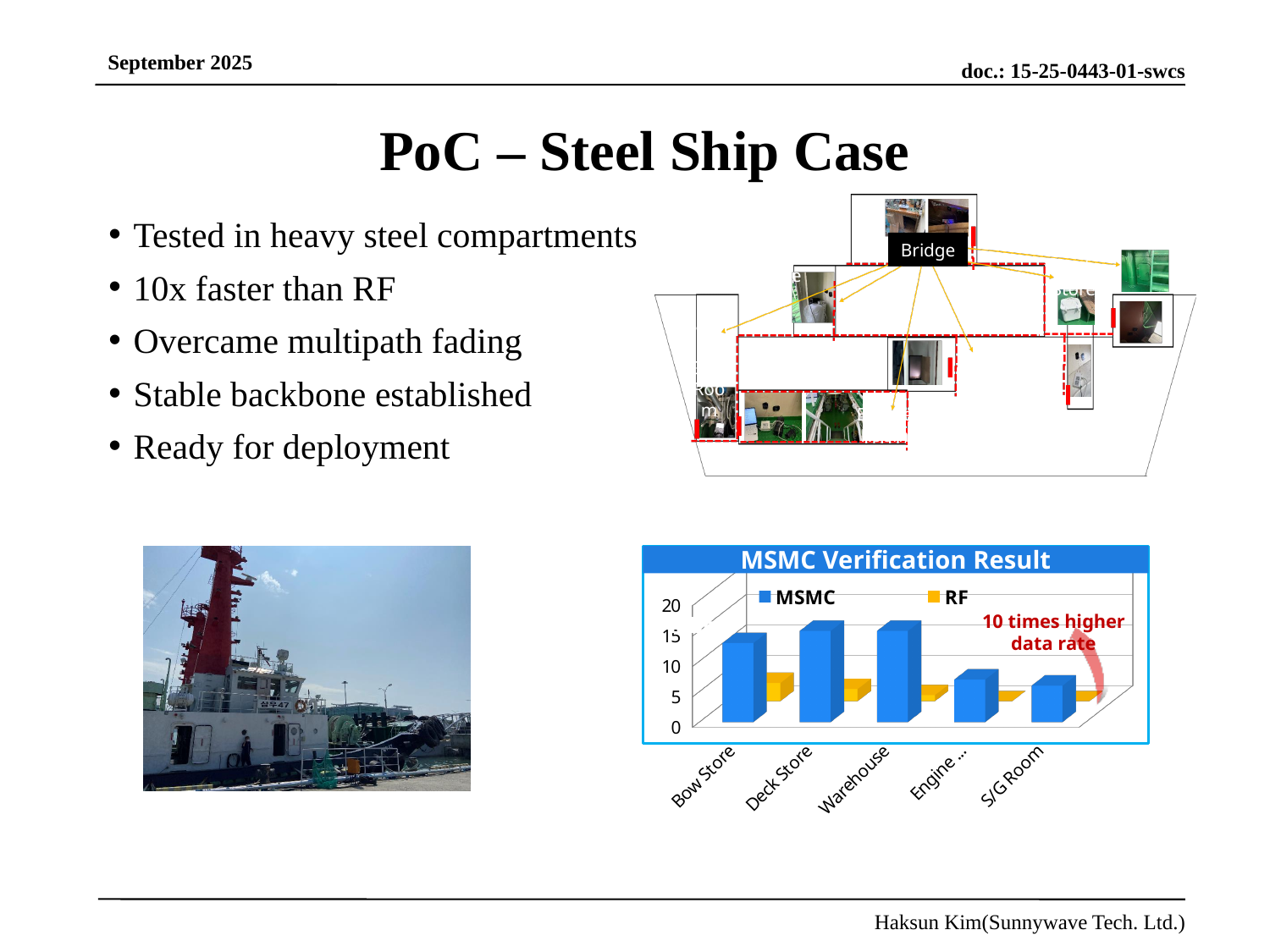
In the MSMC Verification Result chart, which is larger for Warehouse: the MSMC value or the RF value? MSMC What is the title of the chart on the slide? MSMC Verification Result In the MSMC Verification Result chart, is the MSMC value for Warehouse greater or less than 10? greater What kind of chart is the MSMC Verification Result chart? bar chart In the MSMC Verification Result chart, is the MSMC value for Bow Store greater or less than 10? greater Which two series are listed in the legend of the MSMC Verification Result chart? MSMC and RF How many series does the legend of the MSMC Verification Result chart list? 2 In the MSMC Verification Result chart, is the MSMC value for S/G Room greater or less than 10? less In the MSMC Verification Result chart, which has the larger MSMC value: Deck Store or S/G Room? Deck Store In the MSMC Verification Result chart, which series has the larger value in every category? MSMC How many categories are shown on the x axis of the MSMC Verification Result chart? 5